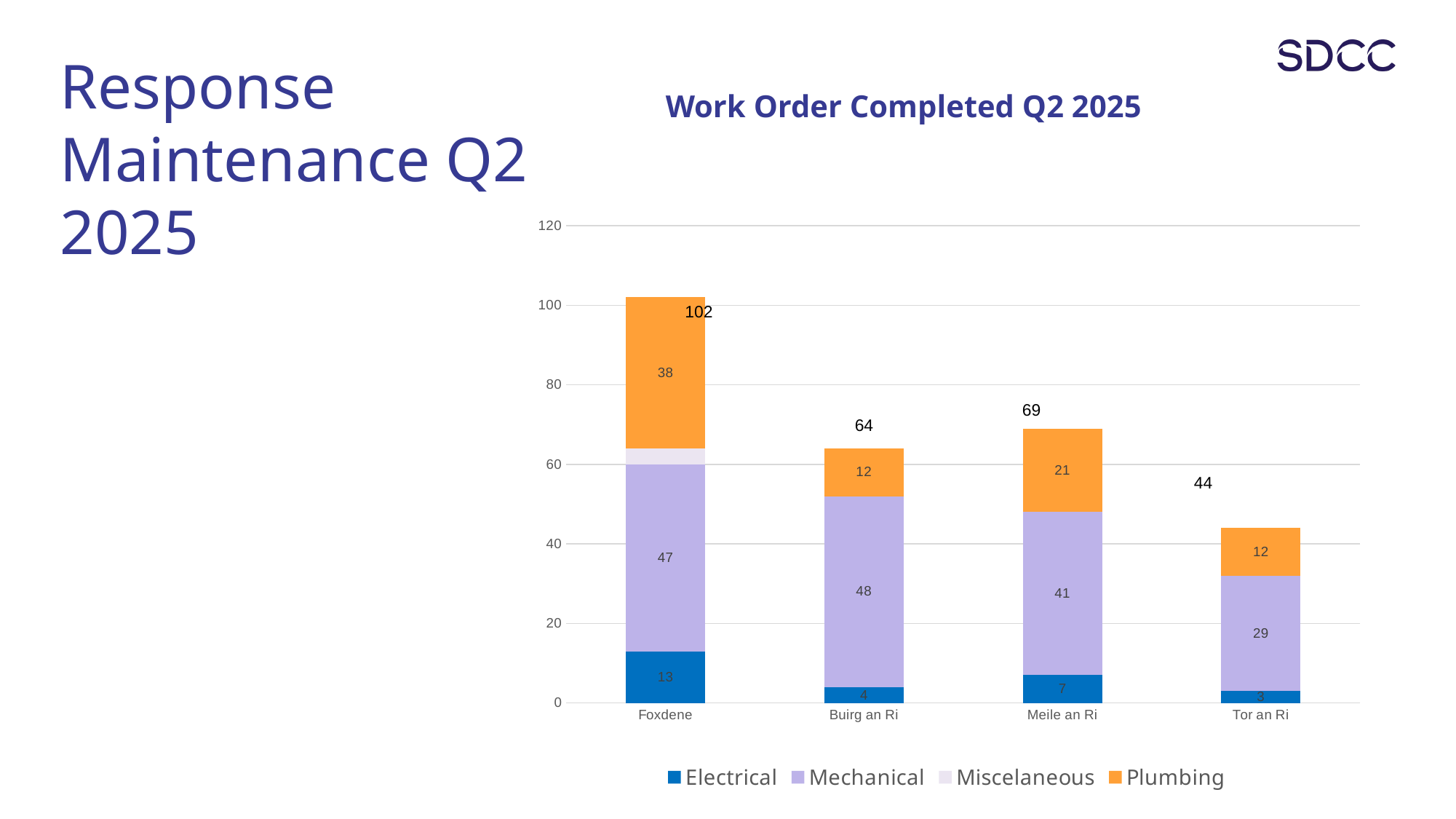
Which is larger, the Plumbing value for Meile an Ri or the Plumbing value for Tor an Ri? Meile an Ri What is the Plumbing value for Foxdene? 38 Which category has the highest total work orders completed? Foxdene What type of chart is shown on the slide? Stacked bar chart What is the Mechanical value for Buirg an Ri? 48 How many series does the legend list? 4 What is the title of the chart? Work Order Completed Q2 2025 Which category has the lowest total work orders completed? Tor an Ri What is the total of the stacked bar for Tor an Ri? 44 How many categories are shown on the x axis? 4 What is the Electrical value for Meile an Ri? 7 What is the difference between the totals for Foxdene and Buirg an Ri? 38